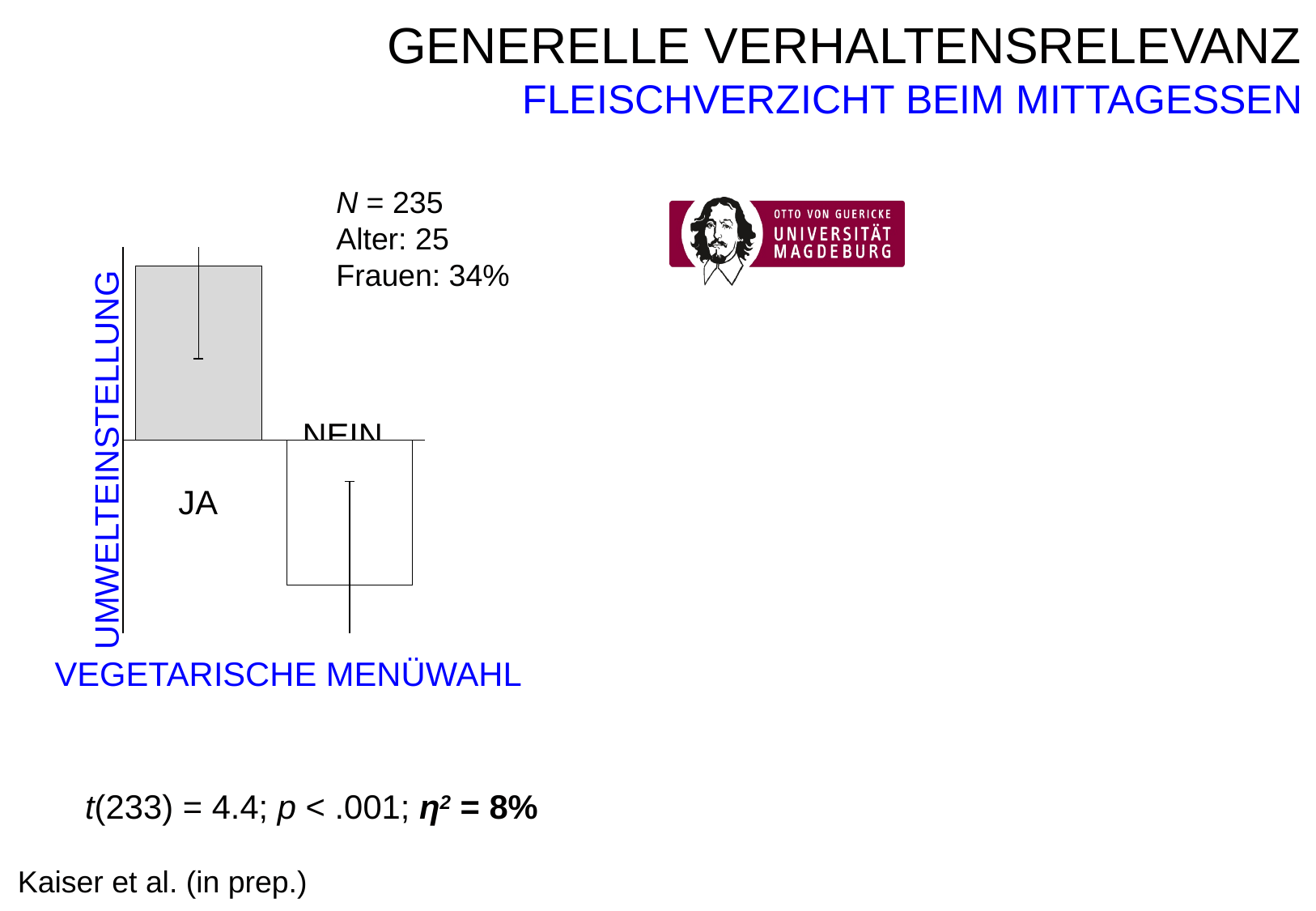
How many categories (bars) does the chart show? 2 What is the label of the vertical axis of the chart? UMWELTEINSTELLUNG Which category has the lowest value for UMWELTEINSTELLUNG? NEIN Do the values rise or fall going from JA to NEIN along the x axis? fall Is the value for NEIN larger or smaller than the value for JA? smaller Which category has the higher value for UMWELTEINSTELLUNG, JA or NEIN? JA What kind of chart is shown on the slide? bar chart What is the label of the horizontal axis of the chart? VEGETARISCHE MENÜWAHL Which bar extends below the baseline of the chart? NEIN